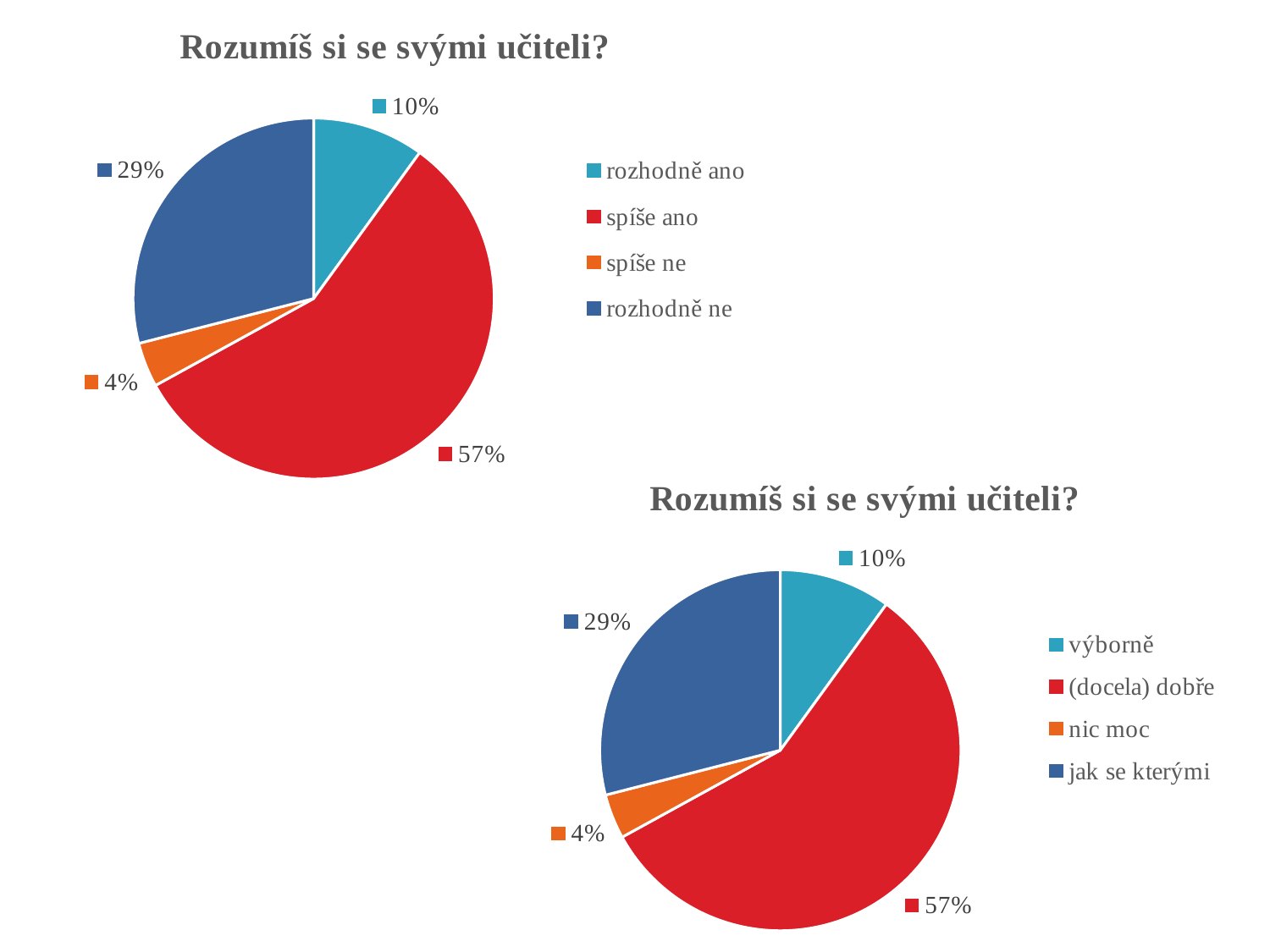
In the bottom-right pie chart, what share does 'nic moc' have? 4% In the bottom-right pie chart, how many categories does the legend list? 4 In the bottom-right pie chart, what share does '(docela) dobře' have? 57% In the top-left pie chart, what share does 'spíše ano' have? 57% In the top-left pie chart, which category has the smallest share? spíše ne In the top-left pie chart, what share does 'rozhodně ne' have? 29% In the bottom-right pie chart, what is the combined share of 'výborně' and '(docela) dobře'? 67% What type of chart is the top-left chart? pie chart In the top-left pie chart, which category has the largest share? spíše ano In the top-left pie chart, what is the difference between the shares of 'rozhodně ne' and 'rozhodně ano'? 19% In the bottom-right pie chart, which is larger: 'výborně' or 'jak se kterými'? jak se kterými What is the title of the bottom-right chart? Rozumíš si se svými učiteli?